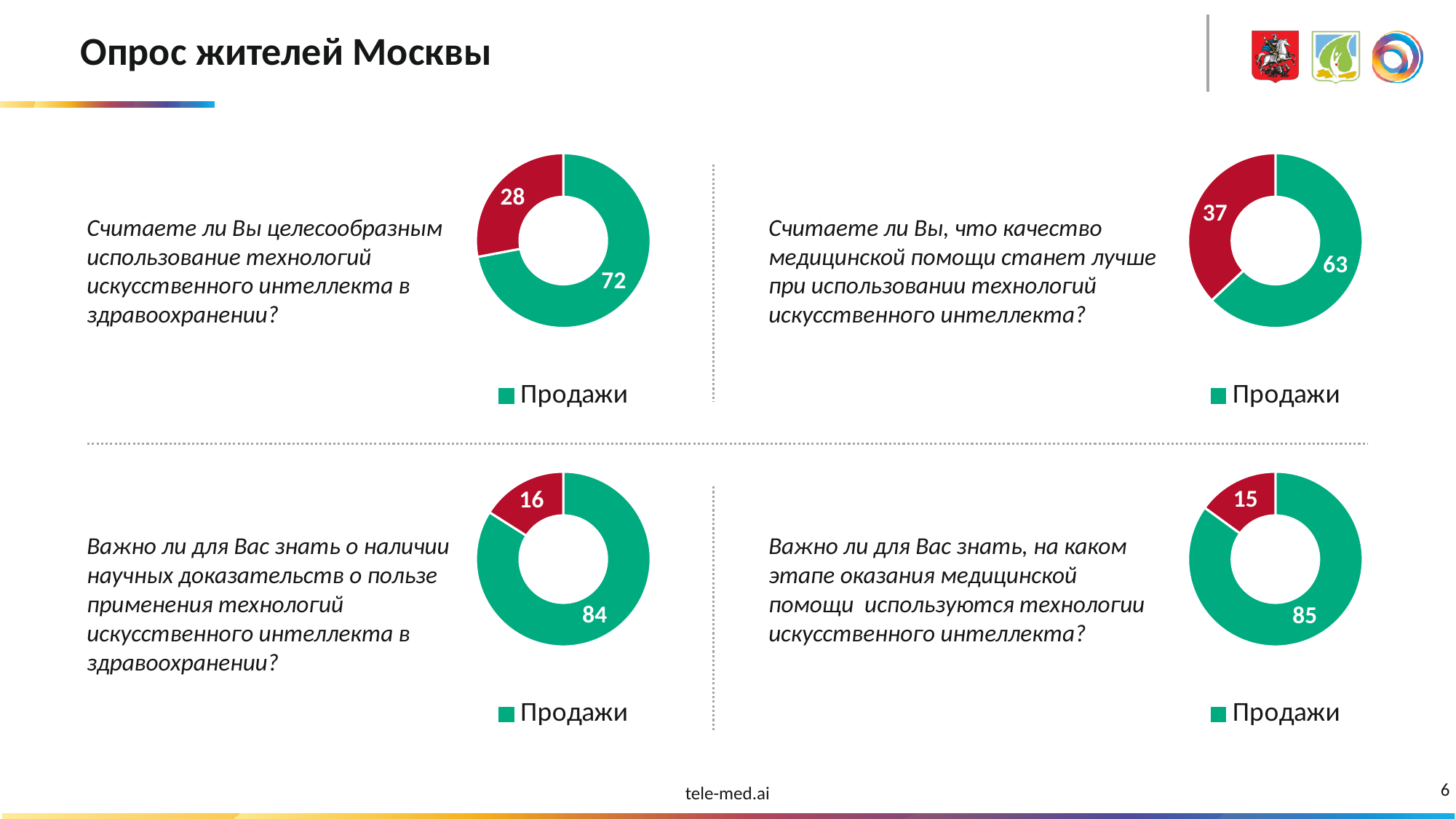
In the bottom-left donut chart, which slice is larger, the green one or the red one? green Across the four donut charts, which chart has the smallest red slice value? bottom-right (15) In the top-right donut chart, what value is shown on the green slice? 63 In the top-right donut chart, what is the difference between the green slice value and the red slice value? 26 In the top-left donut chart, what value is shown on the red slice? 28 In the top-left donut chart, what value is shown on the green slice? 72 In the bottom-right donut chart, what value is shown on the red slice? 15 In the top-right donut chart, what value is shown on the red slice? 37 Across the four donut charts, which chart has the largest green slice value? bottom-right (85) In the bottom-left donut chart, what value is shown on the green slice? 84 How many slices does the bottom-right donut chart have? 2 What type of chart is used in the top-left position of the slide? donut (pie) chart